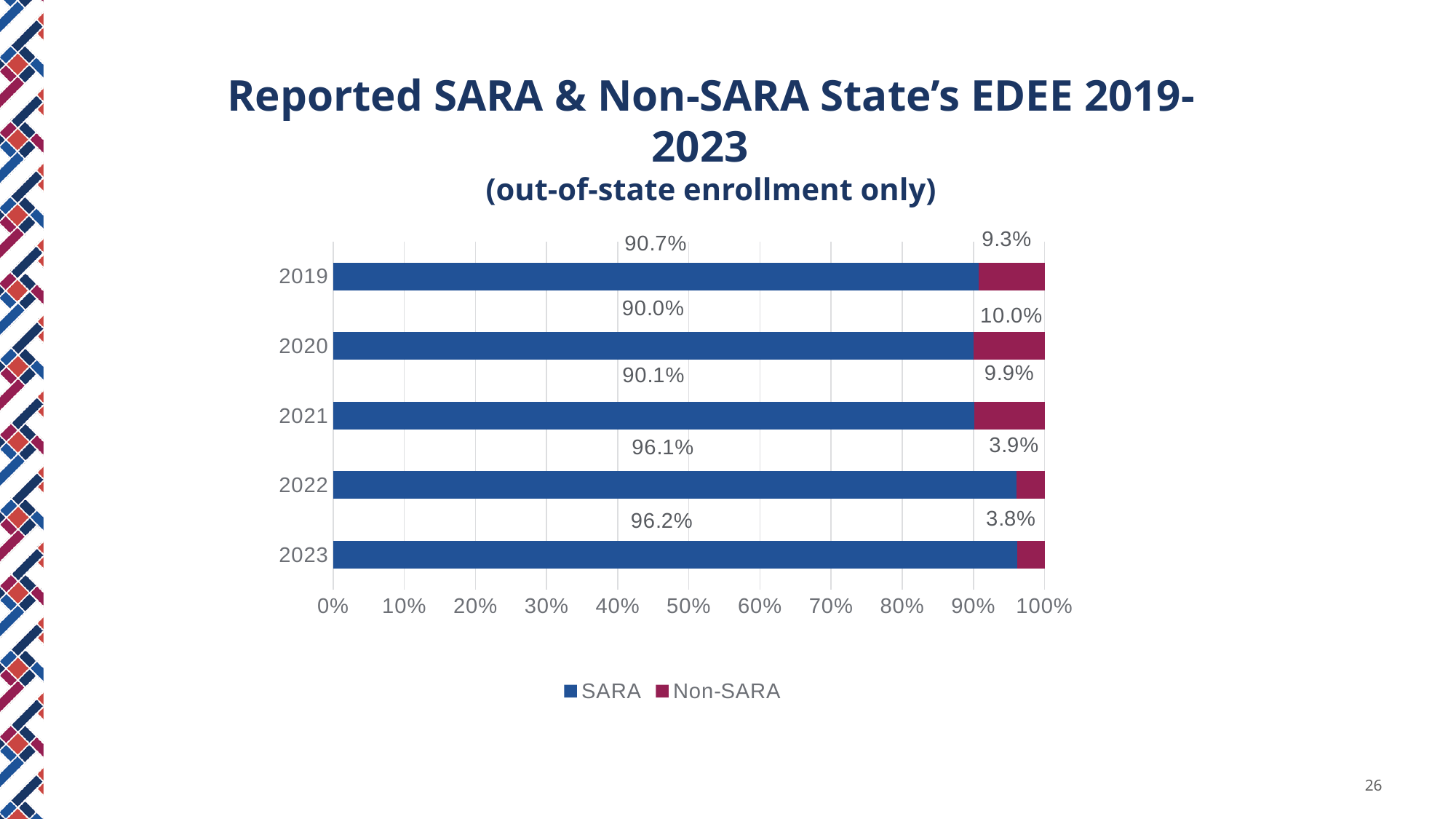
Which year has the highest Non-SARA share? 2020 What kind of chart is shown on the slide? Stacked bar chart Which year has the lowest Non-SARA share? 2023 How many series does the legend list? 2 What is the SARA value for 2023? 96.2% Is the SARA value for 2021 larger or smaller than the SARA value for 2022? smaller What is the SARA value for 2019? 90.7% How many years are shown on the chart? 5 What is the difference between the SARA values for 2022 and 2021? 6.0% What is the Non-SARA value for 2022? 3.9% Which year has the highest SARA share? 2023 What is the Non-SARA value for 2020? 10.0%